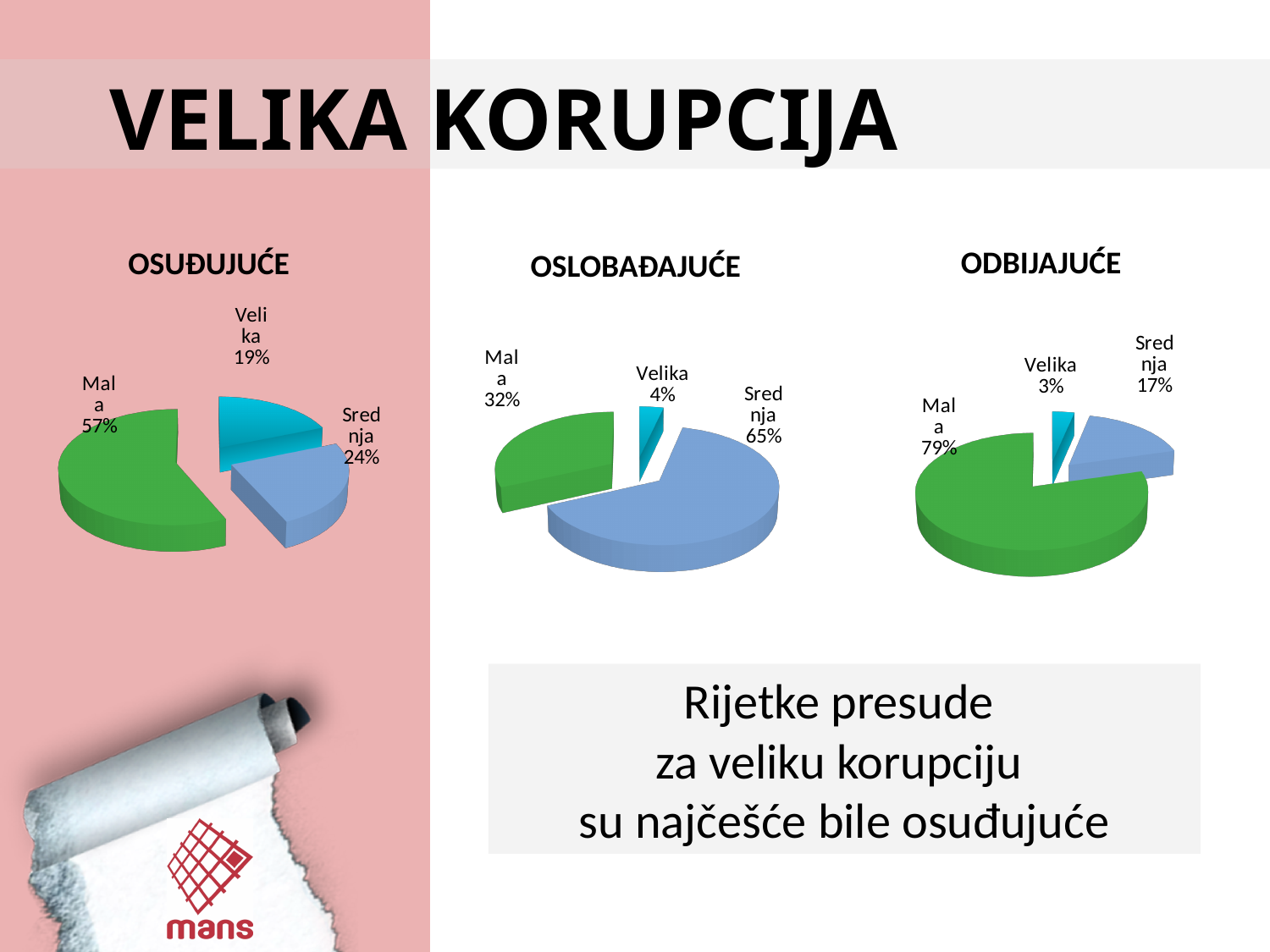
How many charts are shown on the slide? 3 What type of chart is used for OSUĐUJUĆE? Pie chart In the OSUĐUJUĆE pie chart, what is the difference between the Mala and Srednja shares? 33% In the OSUĐUJUĆE pie chart, what share does Velika have? 19% How many categories does the ODBIJAJUĆE pie chart show? 3 In the ODBIJAJUĆE pie chart, what share does Velika have? 3% In the OSLOBAĐAJUĆE pie chart, what share does Srednja have? 65% In the OSLOBAĐAJUĆE pie chart, which category has the smallest share? Velika In the OSUĐUJUĆE pie chart, what share does Mala have? 57% In the OSLOBAĐAJUĆE pie chart, which is larger, Mala or Srednja? Srednja In the ODBIJAJUĆE pie chart, what is the difference between the Mala and Srednja shares? 62% In the ODBIJAJUĆE pie chart, which category has the largest share? Mala